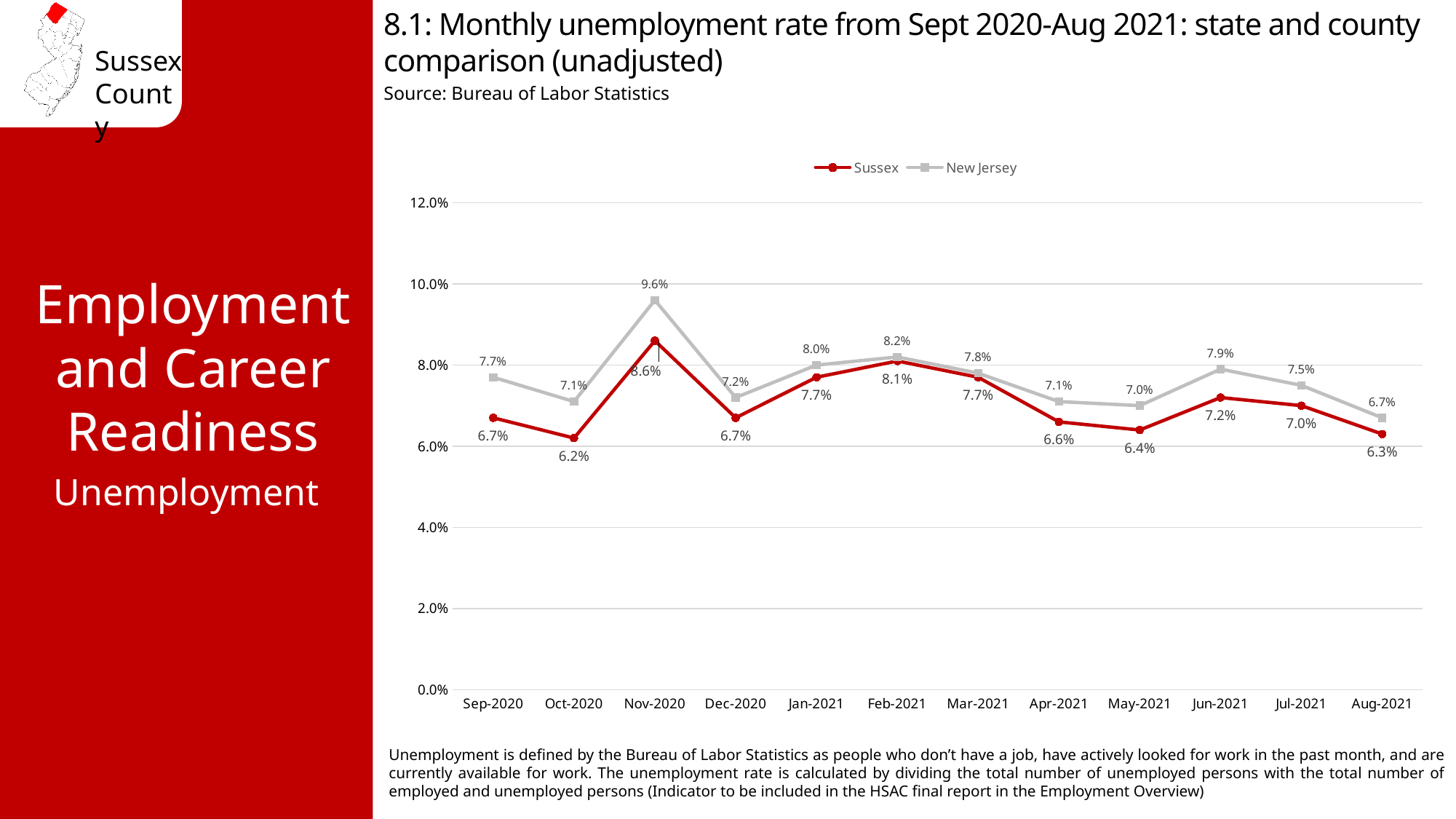
In which month was the New Jersey unemployment rate highest? Nov-2020 How much higher was the New Jersey rate than the Sussex rate in Nov-2020? 1.0 percentage points In Feb-2021, which had the higher unemployment rate, Sussex or New Jersey? New Jersey In which month was the Sussex unemployment rate lowest? Oct-2020 What was the Sussex unemployment rate in Aug-2021? 6.3% How many series does the legend list? 2 What source is cited for the chart data? Bureau of Labor Statistics Did the Sussex unemployment rate rise or fall from Jun-2021 to Aug-2021? Fall What was the Sussex unemployment rate in Nov-2020? 8.6% What kind of chart is shown on the slide? Line chart How many months are plotted on the x axis? 12 What was the New Jersey unemployment rate in Nov-2020? 9.6%